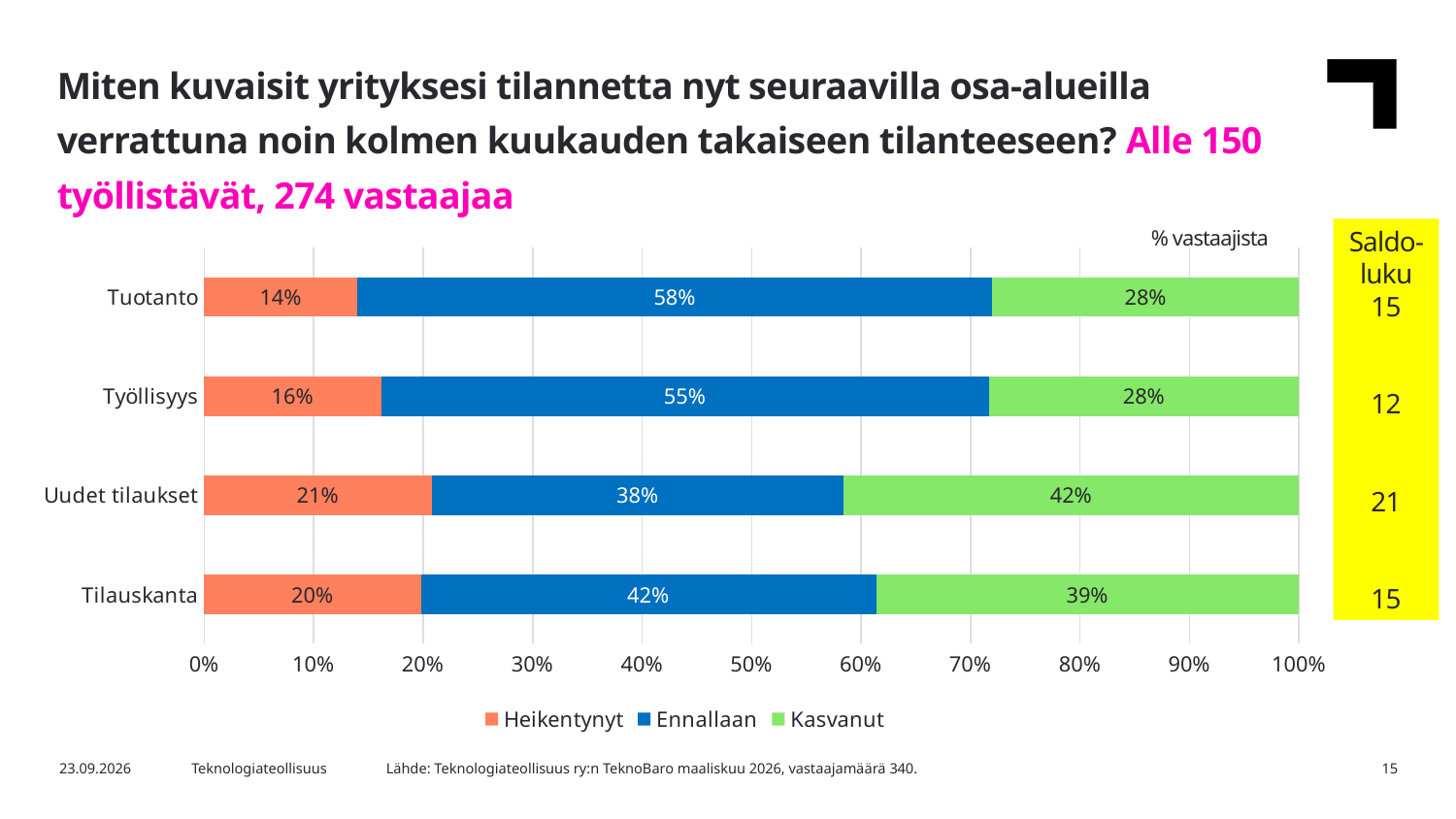
Which category has the lowest "Ennallaan" share? Uudet tilaukset Which legend entry is shown in green? Kasvanut What is the "Heikentynyt" value for Tilauskanta? 20% What is the saldoluku (balance figure) shown for Uudet tilaukset? 21 What percentage of respondents answered "Ennallaan" for Tuotanto? 58% What is the difference between the "Kasvanut" values for Uudet tilaukset and Tuotanto? 14 percentage points How many categories are shown on the y axis of the chart? 4 How many series does the legend list? 3 What kind of chart is shown on the slide? Stacked bar chart What is the "Kasvanut" value for Uudet tilaukset? 42% Which category has the highest "Heikentynyt" share? Uudet tilaukset Which is larger: the "Ennallaan" value for Työllisyys or for Tilauskanta? Työllisyys